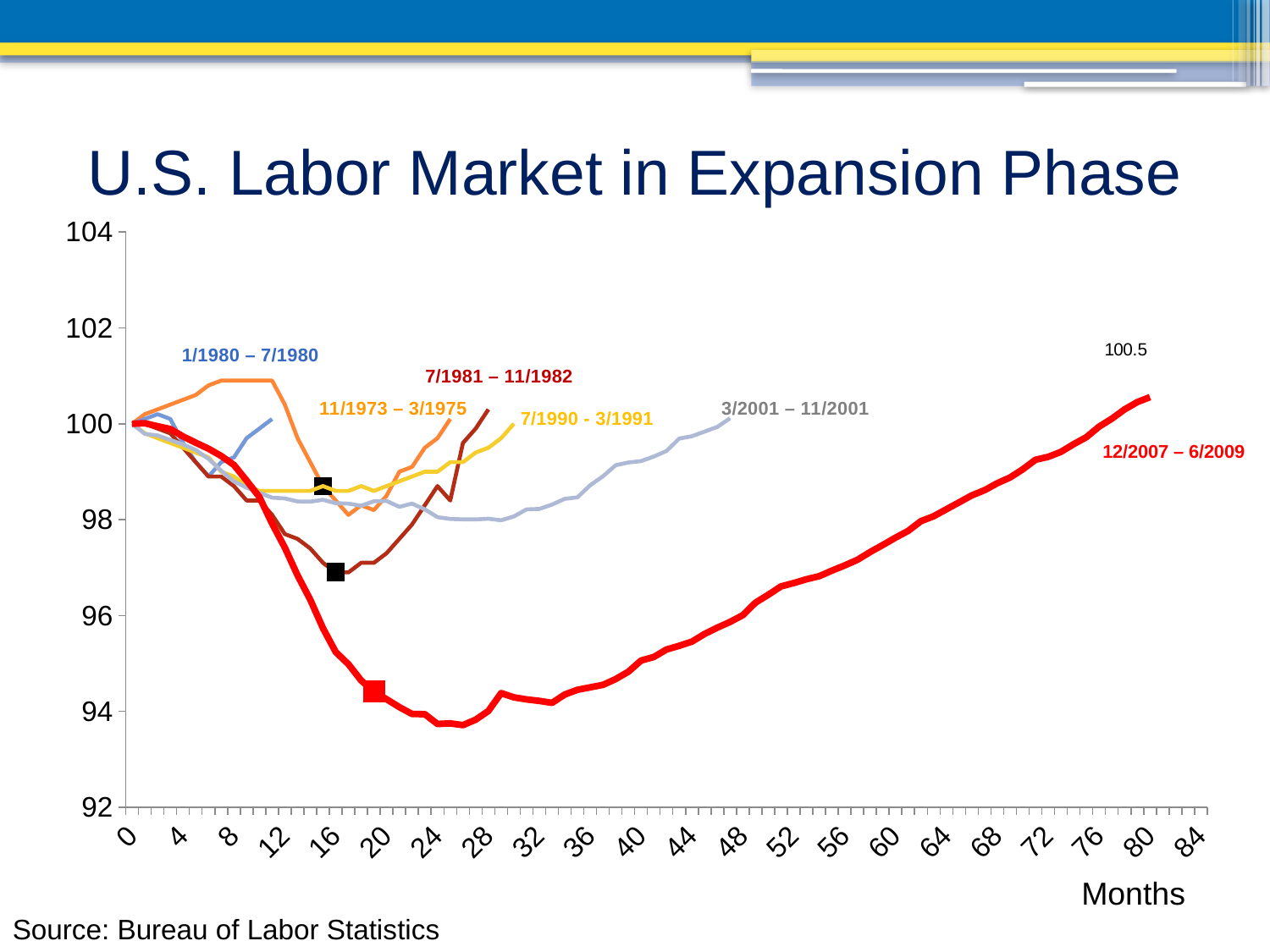
What kind of chart is shown on the slide? line chart What is the label on the x axis of the chart? Months Does the 12/2007 – 6/2009 line rise or fall between month 28 and month 80? rise Which recession line extends the furthest along the Months axis? 12/2007 – 6/2009 Which recession line reaches the lowest point on the chart? 12/2007 – 6/2009 How many recession periods are labeled as lines on the chart? 6 What is the title of the chart? U.S. Labor Market in Expansion Phase Is the value of the 12/2007 – 6/2009 line at month 40 greater or less than 96? less At month 20, which line is higher: 7/1981 – 11/1982 or 12/2007 – 6/2009? 7/1981 – 11/1982 Is the lowest point of the 12/2007 – 6/2009 line greater or less than 94? less What value is printed at the end of the 12/2007 – 6/2009 line? 100.5 Is the highest point of the 11/1973 – 3/1975 line greater or less than 100? greater